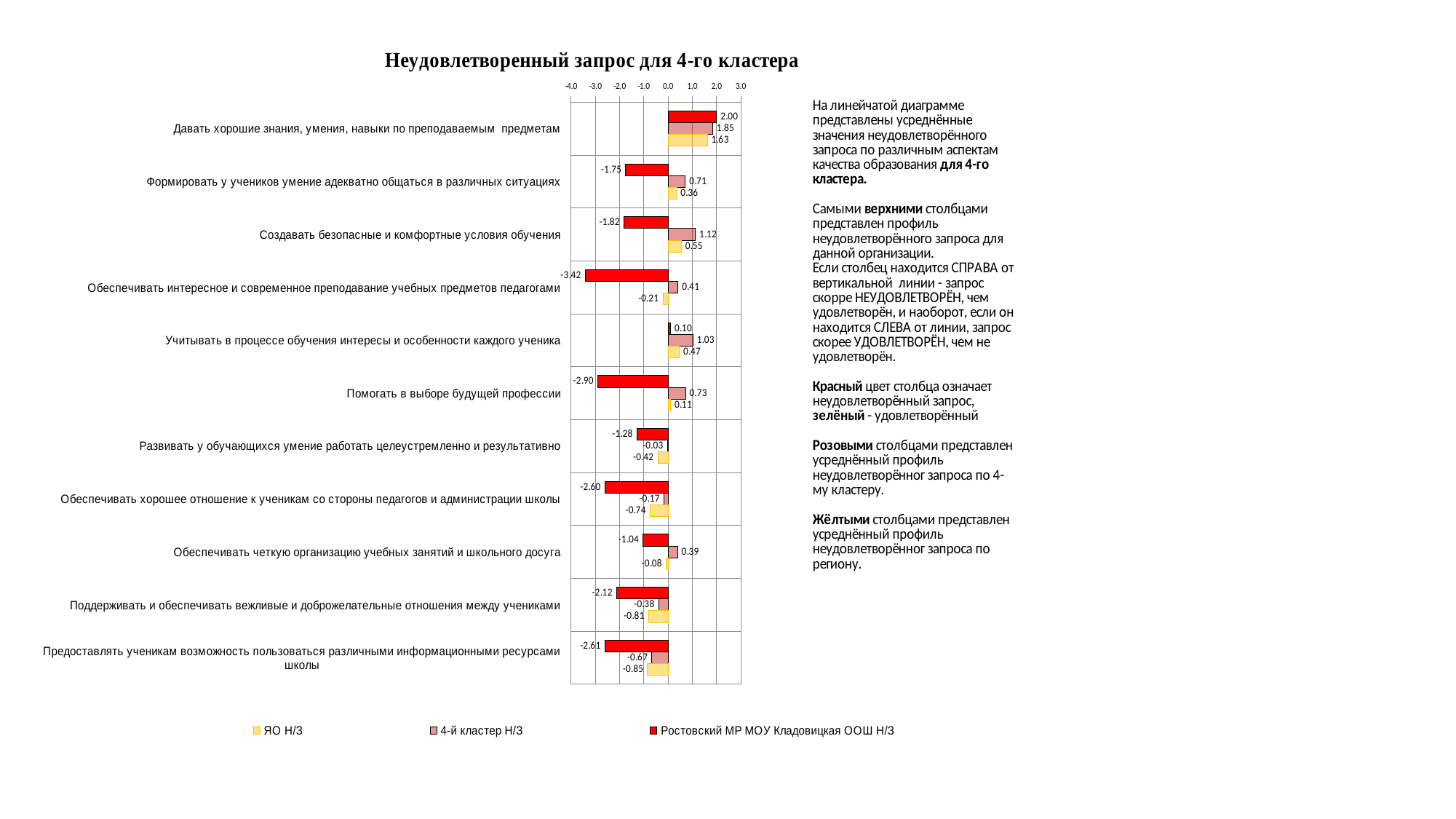
Which colour represents the series 'ЯО Н/З' in the chart? yellow What is the difference between the 'Ростовский МР МОУ Кладовицкая ООШ Н/З' value and the 'ЯО Н/З' value in the category 'Давать хорошие знания, умения, навыки по преподаваемым предметам'? 0.37 What is the value for 'Ростовский МР МОУ Кладовицкая ООШ Н/З' in the category 'Давать хорошие знания, умения, навыки по преподаваемым предметам'? 2.00 How many series does the legend list? 3 What is the value for 'ЯО Н/З' in the category 'Помогать в выборе будущей профессии'? 0.11 In which category does 'Ростовский МР МОУ Кладовицкая ООШ Н/З' have its lowest value? Обеспечивать интересное и современное преподавание учебных предметов педагогами In the category 'Учитывать в процессе обучения интересы и особенности каждого ученика', which is larger: the value for '4-й кластер Н/З' or for 'Ростовский МР МОУ Кладовицкая ООШ Н/З'? 4-й кластер Н/З What kind of chart is shown on the slide? bar chart How many categories are plotted on the chart? 11 In which category does 'ЯО Н/З' have its highest value? Давать хорошие знания, умения, навыки по преподаваемым предметам Is the value for 'Ростовский МР МОУ Кладовицкая ООШ Н/З' in the category 'Помогать в выборе будущей профессии' greater or less than -2.0? less What is the value for '4-й кластер Н/З' in the category 'Создавать безопасные и комфортные условия обучения'? 1.12